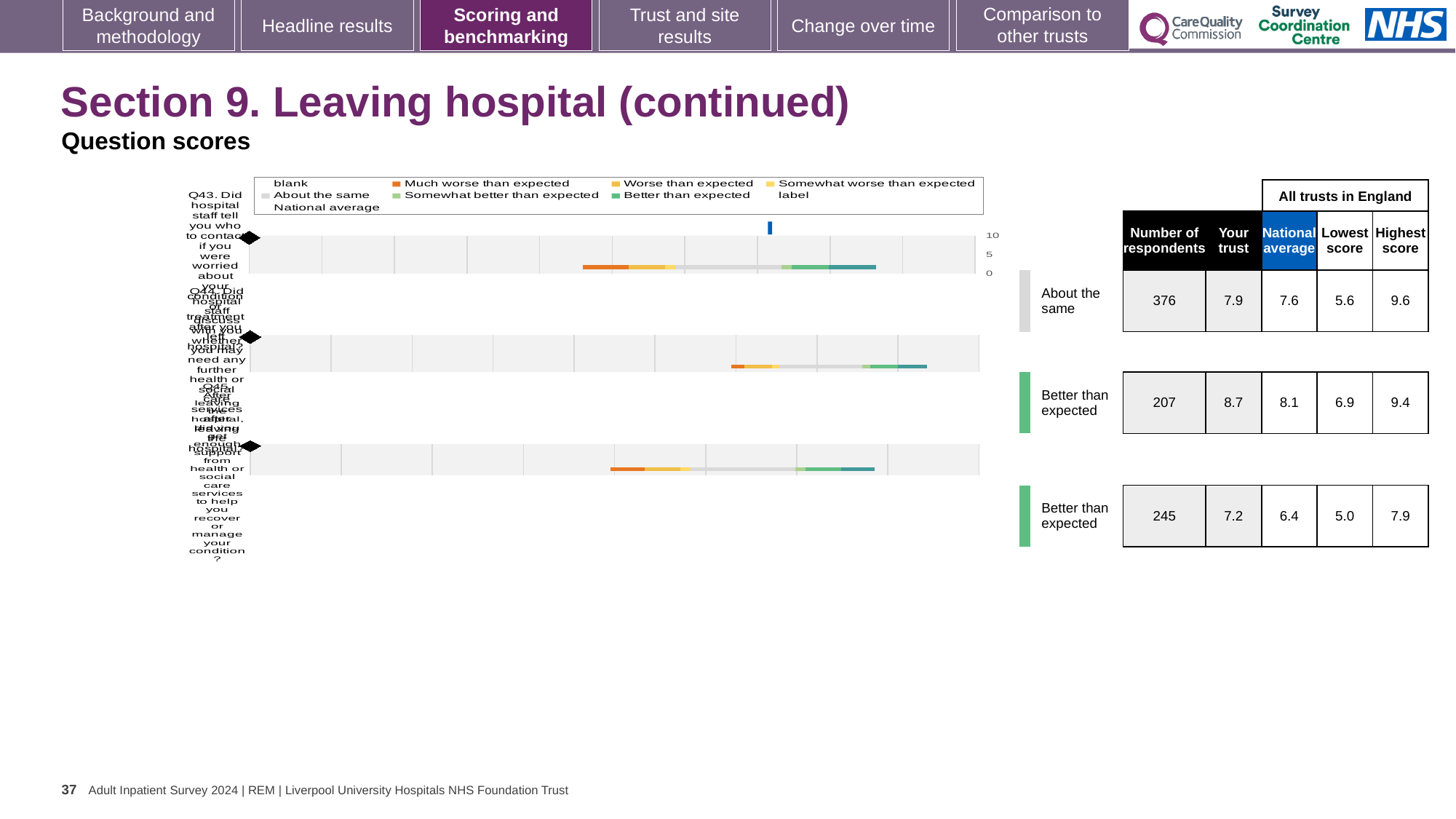
What benchmark category is the first row (Q43) assigned to? About the same What is the lowest score across all trusts in England for the second row of the chart? 6.9 How many respondents are listed for the second row of the chart? 207 For the second row, which is larger: the 'Your trust' score or the national average? Your trust (8.7) What is the national average for the first row (Q43)? 7.6 What is the 'Your trust' score for the first row (Q43), as shown in the table beside the chart? 7.9 Which row has the highest 'Your trust' score? the second row (8.7) How many question rows are plotted in the chart? 3 What is the highest score across all trusts in England for the third row of the chart? 7.9 What kind of chart is shown on the slide? bar chart What is the difference between the 'Your trust' score and the national average for the third row? 0.8 What benchmark category is the third row assigned to? Better than expected